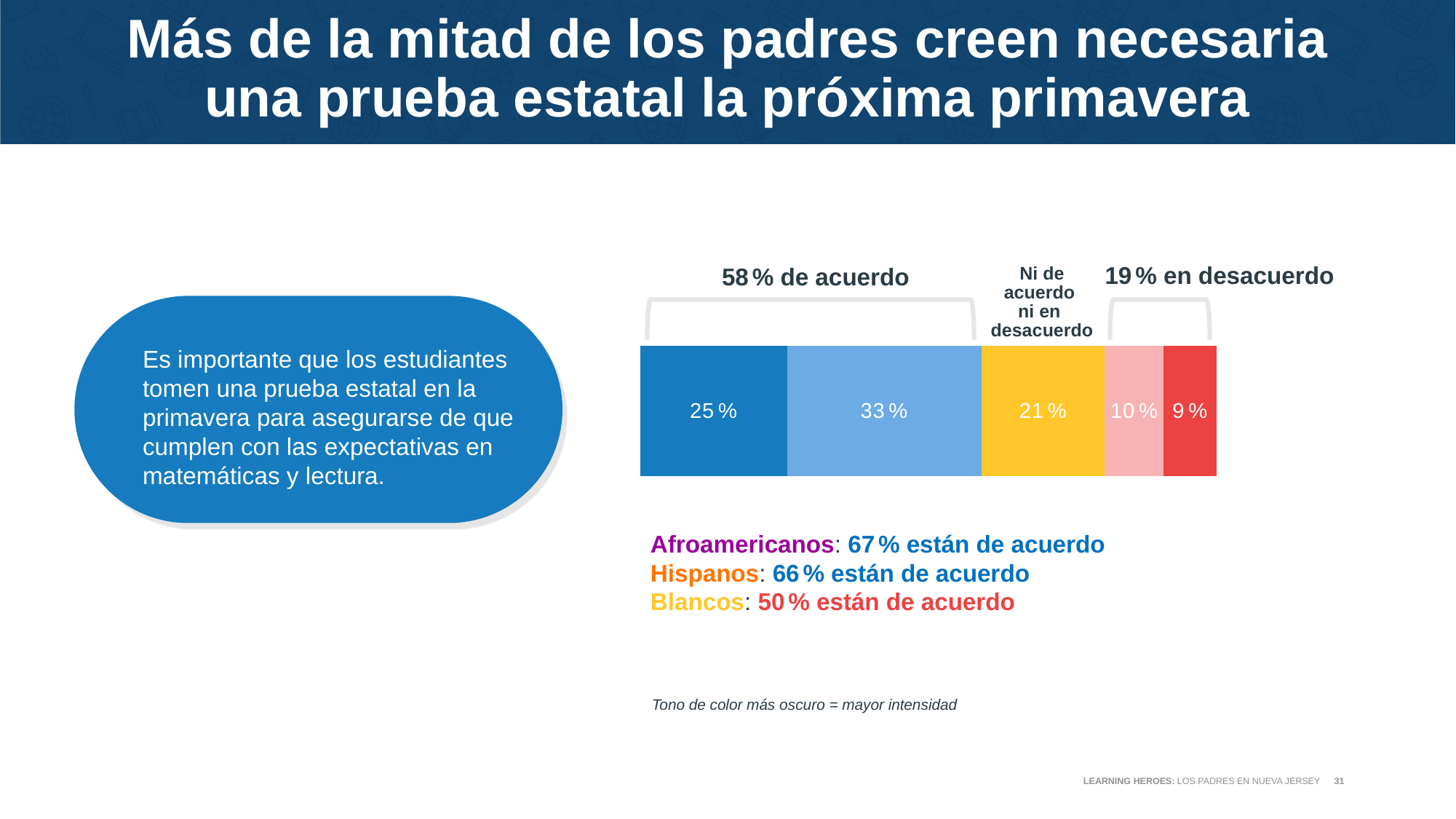
How many segments make up the stacked bar? 5 What is the difference between the 'de acuerdo' total and the 'en desacuerdo' total? 39% What percentage is shown for the lighter blue segment of the bar? 33% What total percentage of parents are 'en desacuerdo' according to the bracket above the bar? 19% Which group has the highest share that agrees: Afroamericanos, Hispanos or Blancos? Afroamericanos Which segment of the bar has the smallest value? 9% What total percentage of parents are 'de acuerdo' according to the bracket above the bar? 58% What percentage is shown for the darkest blue segment of the bar? 25% Which segment of the bar has the largest value? 33% What kind of chart is shown on the slide? Stacked bar chart What percentage is shown for the yellow segment of the bar? 21% What percentage is shown for the red segment at the right end of the bar? 9%